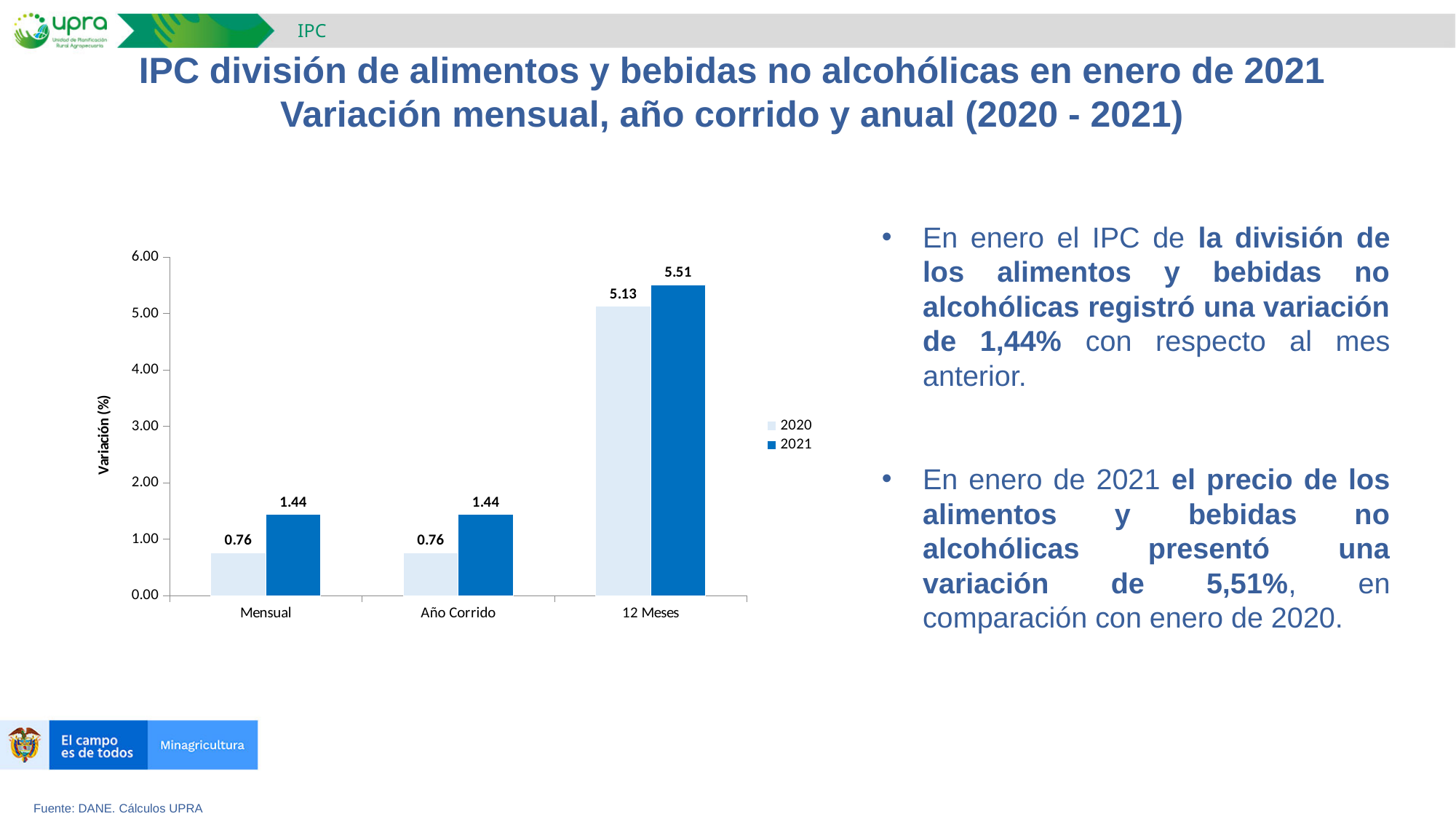
Which category has the highest value for the 2021 series? 12 Meses What kind of chart is shown on the slide? Bar chart What is the value for 2021 in the Año Corrido category? 1.44 Which is larger in the Año Corrido category, the 2020 value or the 2021 value? 2021 What is the value for 2020 in the Mensual category? 0.76 What is the difference between the 2021 and 2020 values in the 12 Meses category? 0.38 What is the difference between the 2021 and 2020 values in the Mensual category? 0.68 How many series does the legend list? 2 What is the value for 2020 in the 12 Meses category? 5.13 What is the value for 2021 in the 12 Meses category? 5.51 How many categories are shown on the x axis? 3